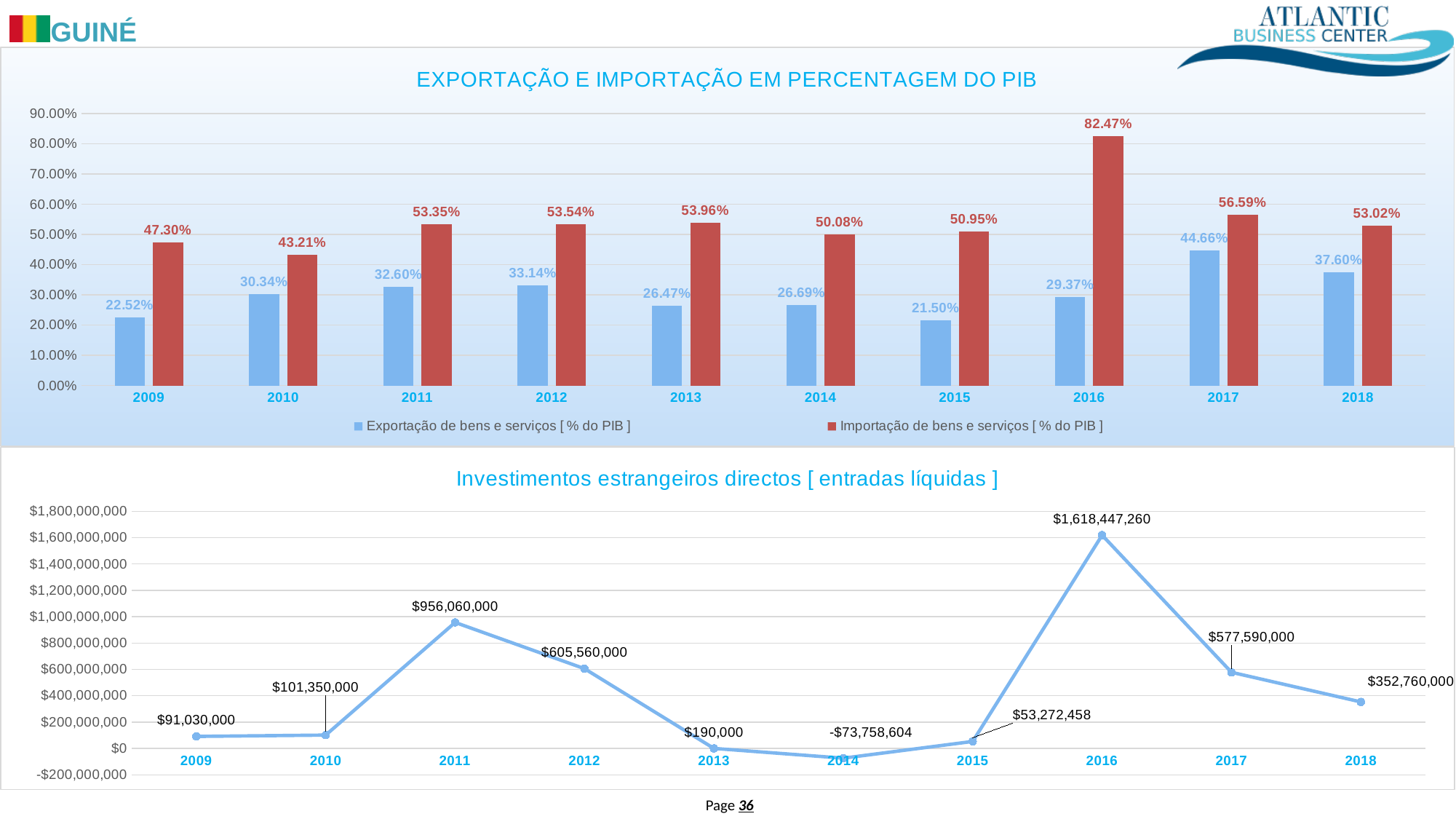
What kind of chart is 'EXPORTAÇÃO E IMPORTAÇÃO EM PERCENTAGEM DO PIB'? Bar chart In the chart 'Investimentos estrangeiros directos [ entradas líquidas ]', which year has the lowest value? 2014 In the chart 'EXPORTAÇÃO E IMPORTAÇÃO EM PERCENTAGEM DO PIB', which year has the highest Importação de bens e serviços value? 2016 What kind of chart is 'Investimentos estrangeiros directos [ entradas líquidas ]'? Line chart In the chart 'EXPORTAÇÃO E IMPORTAÇÃO EM PERCENTAGEM DO PIB', which year has the lowest Exportação de bens e serviços value? 2015 In the chart 'Investimentos estrangeiros directos [ entradas líquidas ]', what is the value for 2011? $956,060,000 In the chart 'EXPORTAÇÃO E IMPORTAÇÃO EM PERCENTAGEM DO PIB', how many series does the legend list? 2 In the chart 'Investimentos estrangeiros directos [ entradas líquidas ]', is the value for 2017 larger than the value for 2018? Yes In the chart 'EXPORTAÇÃO E IMPORTAÇÃO EM PERCENTAGEM DO PIB', how many years are shown on the x axis? 10 In the chart 'EXPORTAÇÃO E IMPORTAÇÃO EM PERCENTAGEM DO PIB', what is the value of Exportação de bens e serviços for 2017? 44.66% In the chart 'EXPORTAÇÃO E IMPORTAÇÃO EM PERCENTAGEM DO PIB', what is the value of Importação de bens e serviços for 2016? 82.47% In the chart 'EXPORTAÇÃO E IMPORTAÇÃO EM PERCENTAGEM DO PIB', what is the difference between Importação and Exportação in 2009? 24.78%